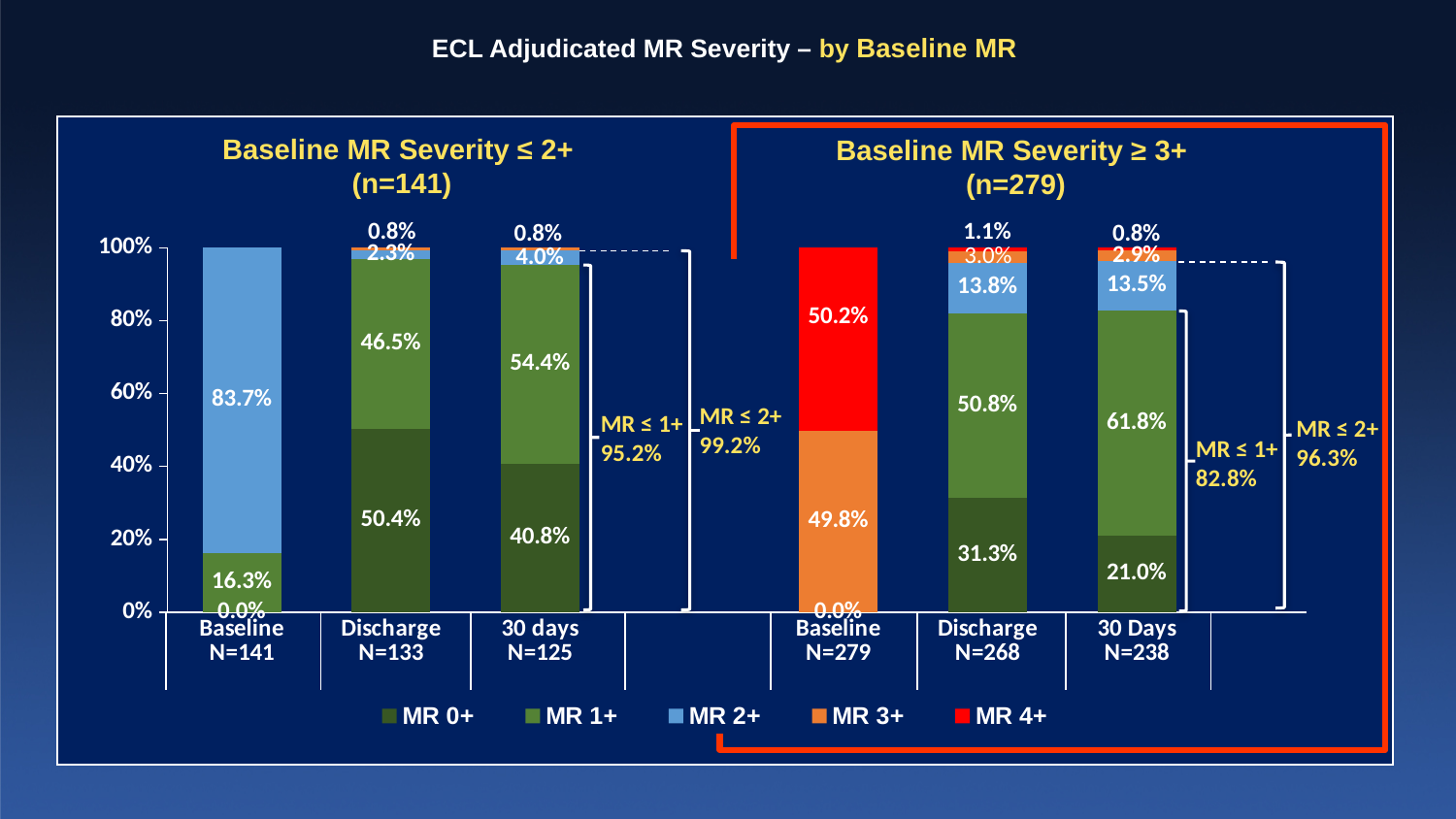
How many bars are plotted in the chart? 6 What is the title of the chart? ECL Adjudicated MR Severity – by Baseline MR Which is larger in the Baseline MR Severity ≥ 3+ group: the MR 0+ value at Discharge (N=268) or at 30 Days (N=238)? Discharge (N=268) What is the difference between the MR 1+ value at 30 days (N=125) and at Discharge (N=133) in the Baseline MR Severity ≤ 2+ group? 7.9% What is the MR ≤ 1+ percentage annotated for the 30 Days bar in the Baseline MR Severity ≥ 3+ group? 82.8% How many series does the legend list? 5 What is the MR 4+ value for the Baseline N=279 bar in the Baseline MR Severity ≥ 3+ group? 50.2% What is the MR 0+ value for the Discharge N=133 bar in the Baseline MR Severity ≤ 2+ group? 50.4% What is the MR 2+ value for the Baseline N=141 bar in the Baseline MR Severity ≤ 2+ group? 83.7% What kind of chart is shown on the slide? Stacked bar chart Which bar has the highest MR 2+ value? Baseline N=141 What is the MR 1+ value for the 30 Days N=238 bar in the Baseline MR Severity ≥ 3+ group? 61.8%